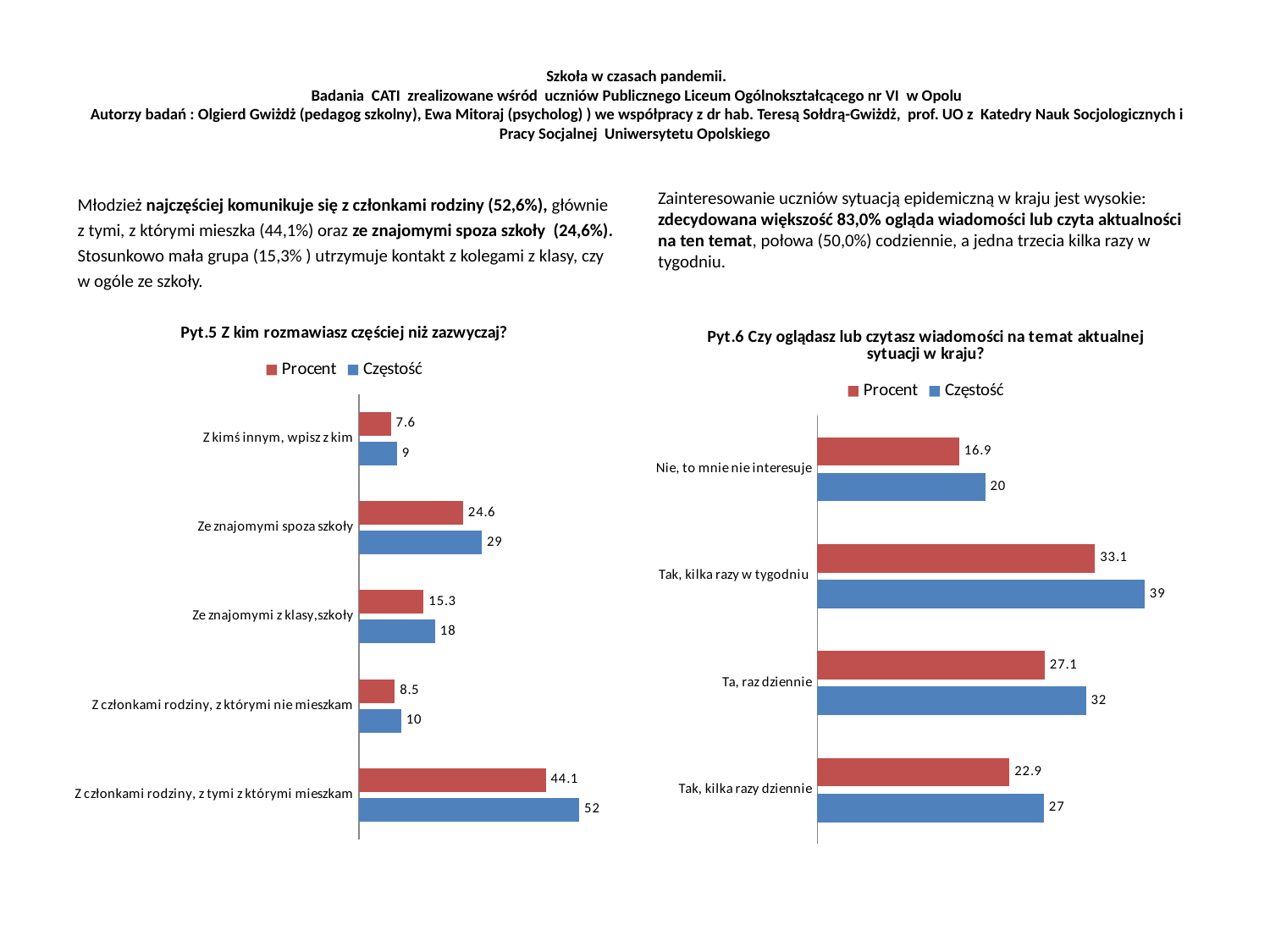
What type of chart is 'Pyt.5 Z kim rozmawiasz częściej niż zazwyczaj?'? Bar chart How many categories are shown in the chart 'Pyt.5 Z kim rozmawiasz częściej niż zazwyczaj?'? 5 In the chart 'Pyt.6 Czy oglądasz lub czytasz wiadomości na temat aktualnej sytuacji w kraju?', what is the Częstość value for 'Nie, to mnie nie interesuje'? 20 In the chart 'Pyt.6 Czy oglądasz lub czytasz wiadomości na temat aktualnej sytuacji w kraju?', which category has the highest Częstość value? Tak, kilka razy w tygodniu How many series does the legend list in the chart 'Pyt.6 Czy oglądasz lub czytasz wiadomości na temat aktualnej sytuacji w kraju?'? 2 In the chart 'Pyt.6 Czy oglądasz lub czytasz wiadomości na temat aktualnej sytuacji w kraju?', which is larger: the Procent value for 'Ta, raz dziennie' or for 'Tak, kilka razy dziennie'? Ta, raz dziennie In the chart 'Pyt.5 Z kim rozmawiasz częściej niż zazwyczaj?', which category has the highest Procent value? Z członkami rodziny, z tymi z którymi mieszkam In the chart 'Pyt.5 Z kim rozmawiasz częściej niż zazwyczaj?', what is the Częstość value for 'Z członkami rodziny, z tymi z którymi mieszkam'? 52 In the chart 'Pyt.5 Z kim rozmawiasz częściej niż zazwyczaj?', which category has the lowest Częstość value? Z kimś innym, wpisz z kim In the chart 'Pyt.5 Z kim rozmawiasz częściej niż zazwyczaj?', what is the Procent value for 'Ze znajomymi spoza szkoły'? 24.6 In the chart 'Pyt.6 Czy oglądasz lub czytasz wiadomości na temat aktualnej sytuacji w kraju?', what is the Procent value for 'Tak, kilka razy w tygodniu'? 33.1 In the chart 'Pyt.5 Z kim rozmawiasz częściej niż zazwyczaj?', what is the difference in Częstość between 'Ze znajomymi spoza szkoły' and 'Ze znajomymi z klasy,szkoły'? 11